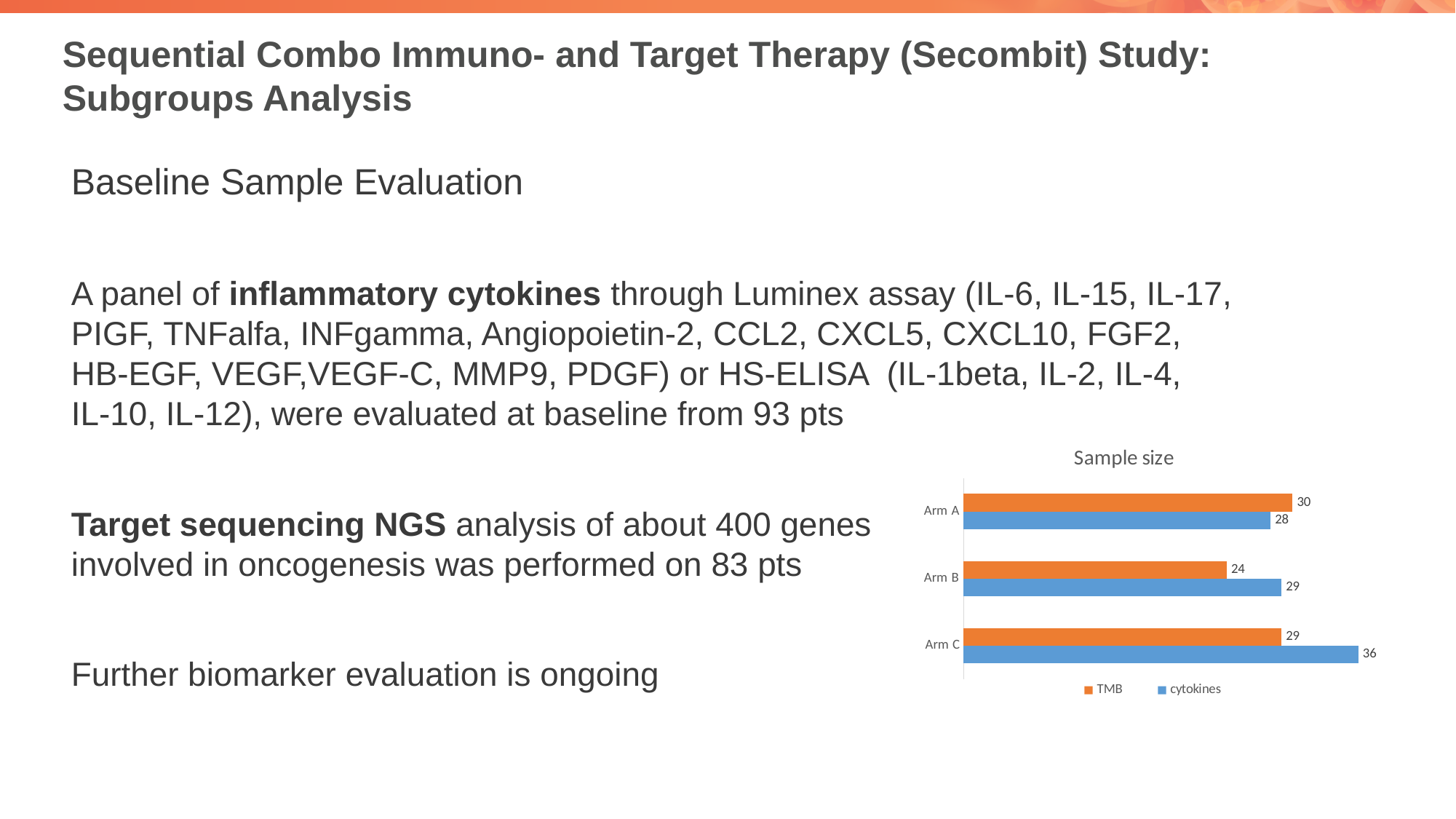
Which arm has the highest cytokines sample size? Arm C What is the cytokines sample size for Arm B? 29 What is the TMB sample size for Arm A? 30 What is the TMB sample size for Arm B? 24 What is the difference between the cytokines and TMB sample sizes for Arm C? 7 What is the cytokines sample size for Arm C? 36 How many series does the legend of the Sample size chart list? 2 What is the title of the chart on the slide? Sample size What type of chart is the Sample size chart? bar chart For Arm A, which is larger: the TMB or the cytokines sample size? TMB Which arm has the lowest TMB sample size? Arm B How many arms are shown in the Sample size chart? 3